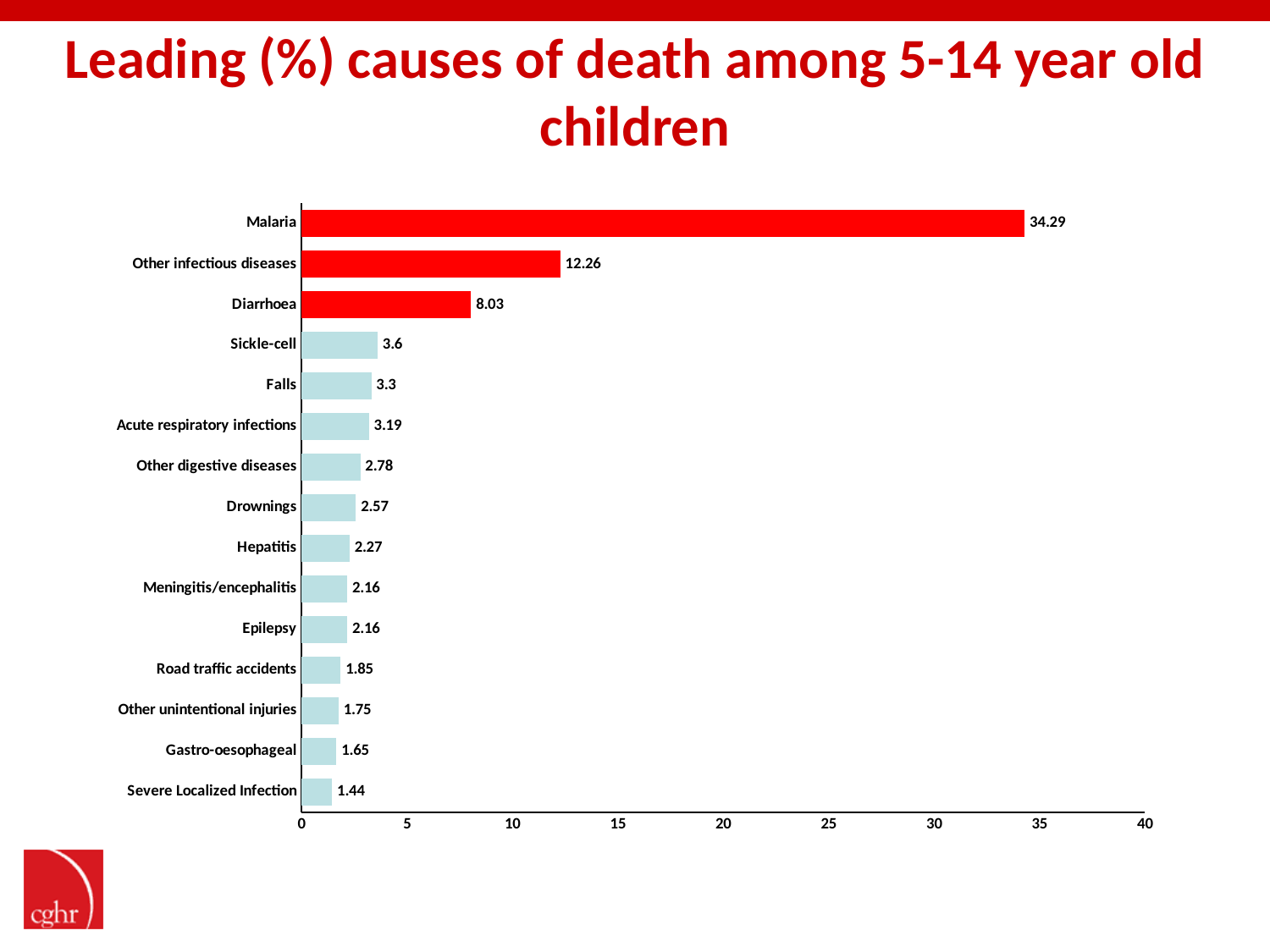
What is the value for Malaria? 34.29 What is the value for Drownings? 2.57 What is the difference between the values for Malaria and Other infectious diseases? 22.03 What is the value for Diarrhoea? 8.03 Is the value for Other infectious diseases greater or less than 10? greater Which is larger, the value for Sickle-cell or the value for Falls? Sickle-cell Which cause of death has the lowest value? Severe Localized Infection Which cause of death has the highest value? Malaria What is the title of the slide? Leading (%) causes of death among 5-14 year old children How many causes of death are shown in the chart? 15 What kind of chart is shown on the slide? bar chart How many bars are coloured red? 3